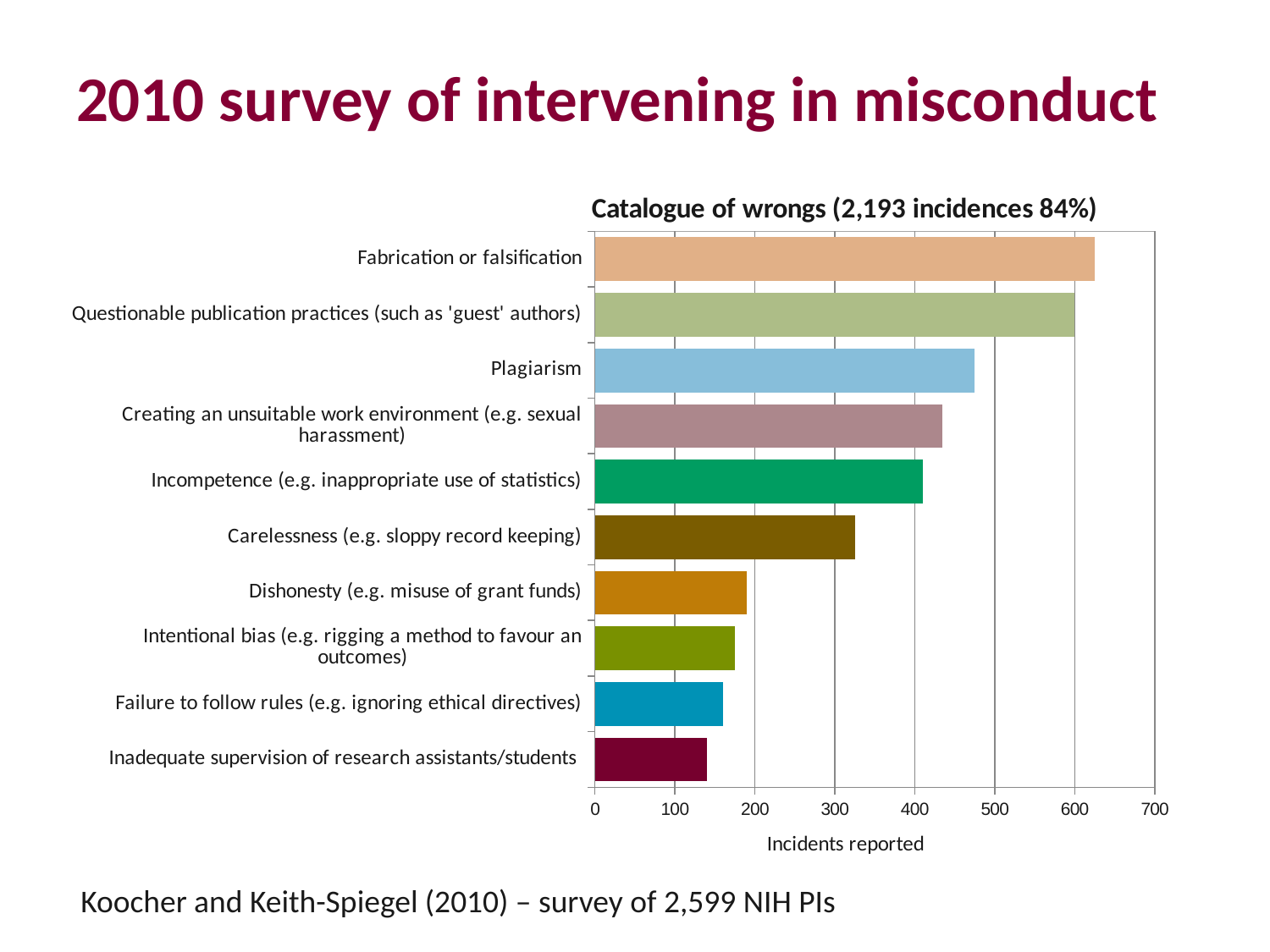
What kind of chart is shown on the slide? Bar chart What is the label on the horizontal axis of the chart? Incidents reported Which has more incidents reported: Plagiarism or Carelessness (e.g. sloppy record keeping)? Plagiarism Is the value for Carelessness (e.g. sloppy record keeping) greater or less than 300? greater Which category has the highest number of incidents reported? Fabrication or falsification Is the value for Inadequate supervision of research assistants/students greater or less than 100? greater Which category has the lowest number of incidents reported? Inadequate supervision of research assistants/students Is the value for Plagiarism greater or less than 400? greater What is the title of the chart? Catalogue of wrongs (2,193 incidences 84%) How many categories of wrongs are plotted in the chart? 10 Which has more incidents reported: Incompetence (e.g. inappropriate use of statistics) or Dishonesty (e.g. misuse of grant funds)? Incompetence (e.g. inappropriate use of statistics)